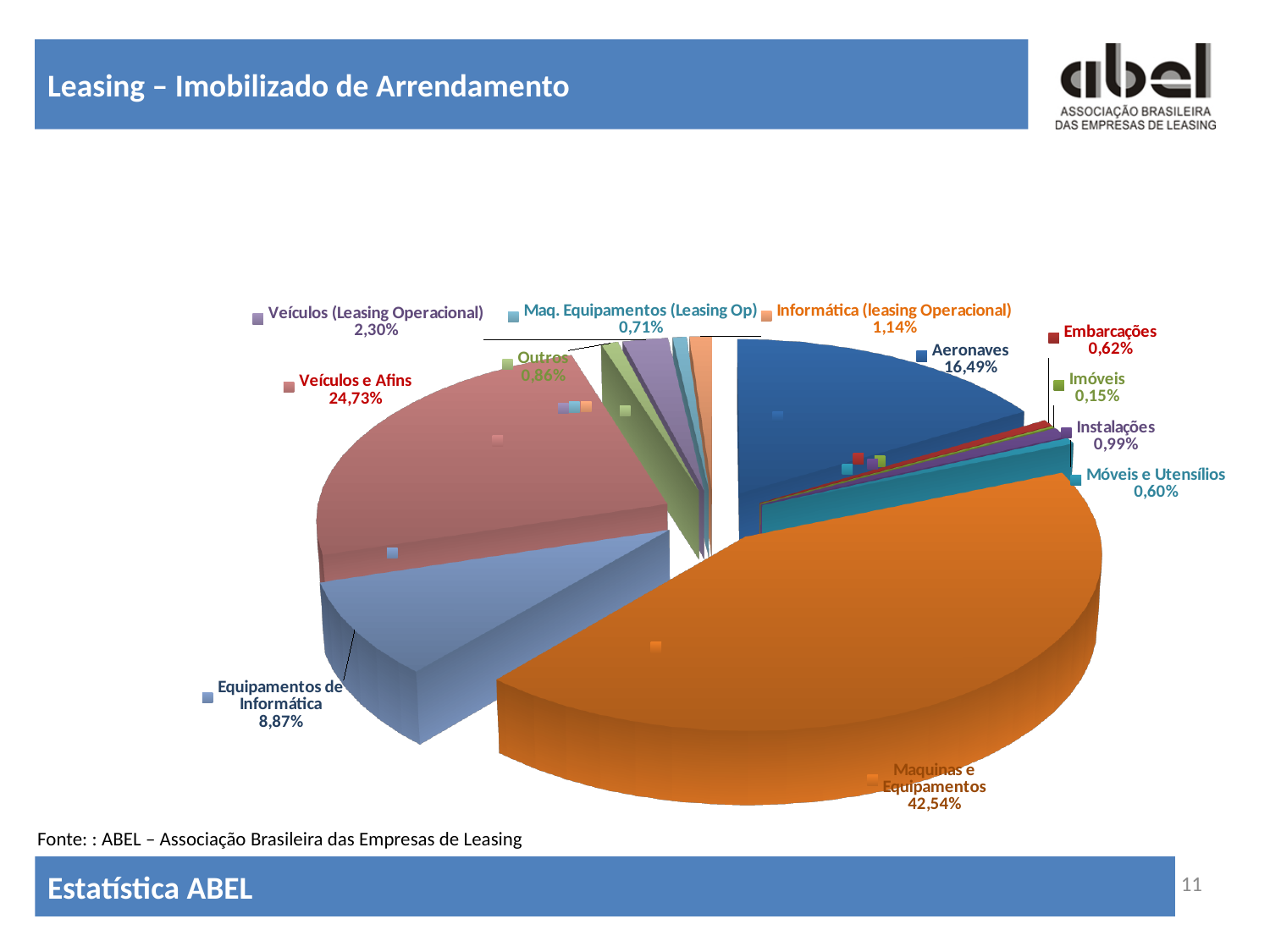
What is the value shown for Equipamentos de Informática? 8,87% Which category has the largest share of the pie? Maquinas e Equipamentos What is the title of the slide containing the chart? Leasing – Imobilizado de Arrendamento Which category has the smallest share of the pie? Imóveis What share of the pie does Maquinas e Equipamentos represent? 42,54% How many categories are shown in the pie chart? 12 What kind of chart is shown on the slide? Pie chart What is the value shown for Veículos e Afins? 24,73% What is the value shown for Aeronaves? 16,49% What is the value shown for Imóveis? 0,15% Which is larger, the share for Aeronaves or the share for Equipamentos de Informática? Aeronaves What is the difference in percentage points between Maquinas e Equipamentos and Veículos e Afins? 17,81